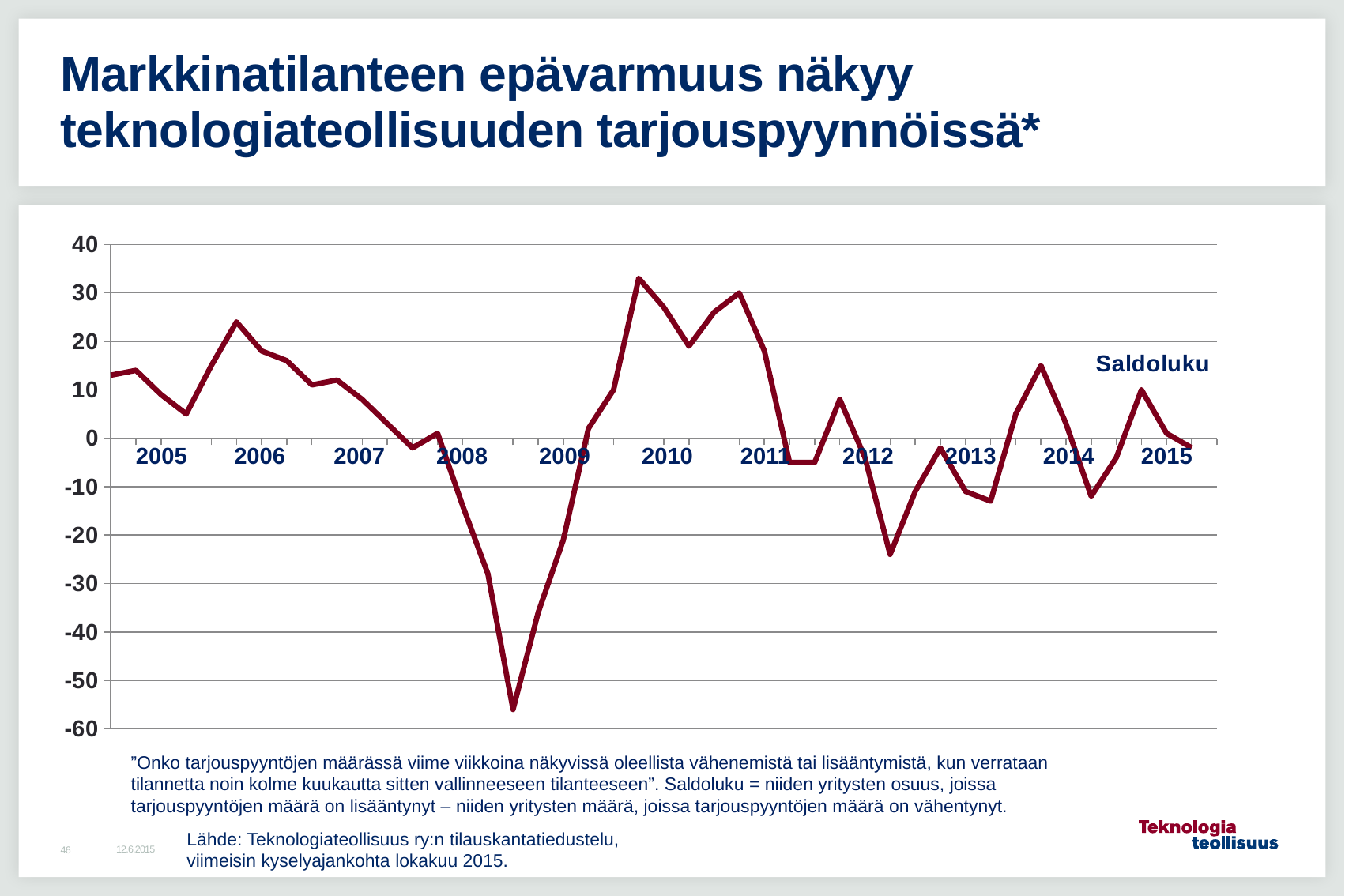
What kind of chart is shown on the slide? line chart How many data series does the chart plot? 1 Is the lowest point of the line in 2012 greater or less than -20? less What is the lowest value shown on the y axis? -60 How many year labels are shown on the x axis? 11 Does the line generally rise or fall between 2006 and 2008? fall Does the line rise or fall from its lowest point in 2008 to the peak in 2009? rise Is the highest point of the line greater or less than 30? greater Is the lowest point of the line greater or less than -50? less What is the name of the series plotted on the chart? Saldoluku